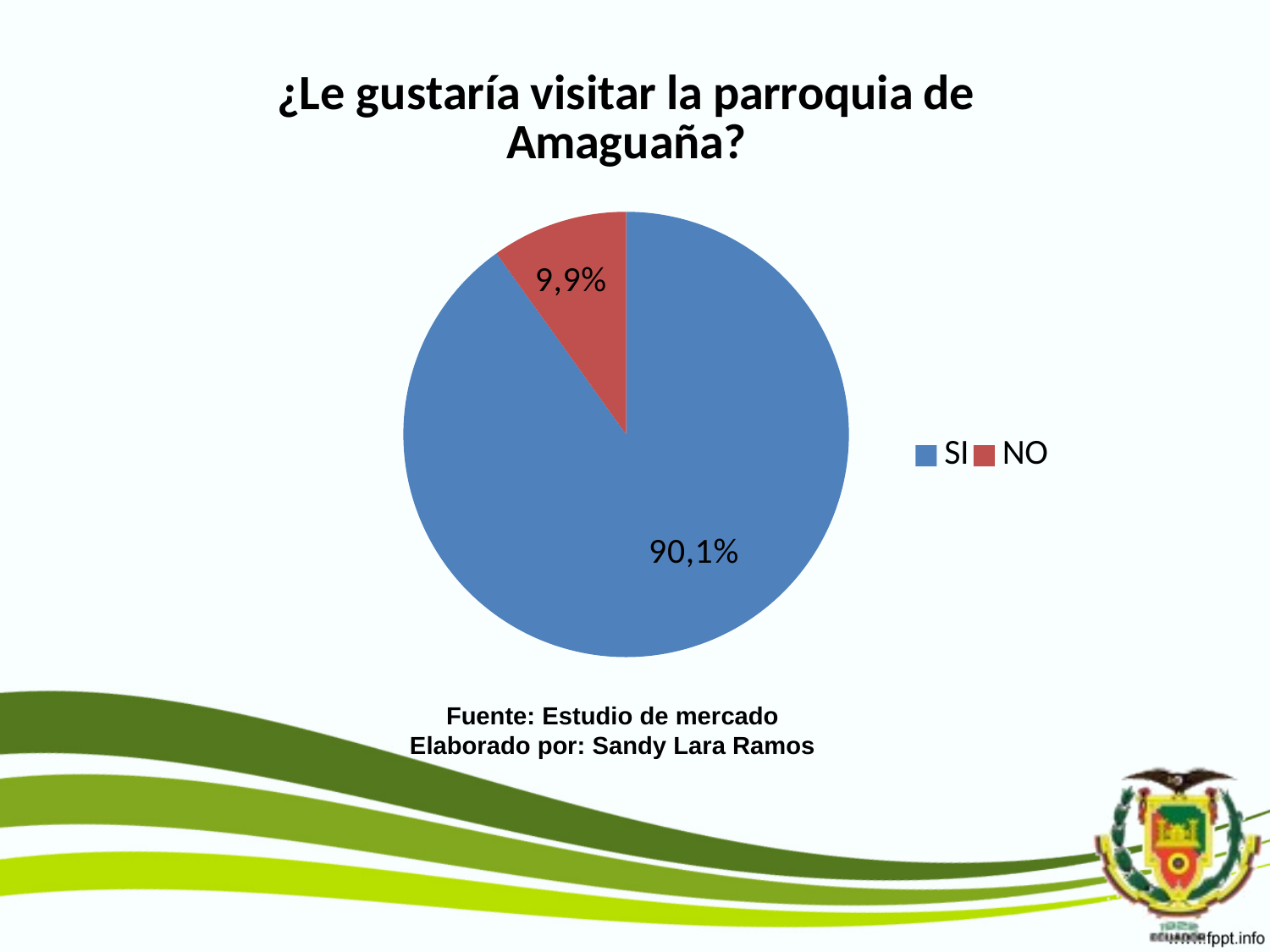
What is the title of the chart? ¿Le gustaría visitar la parroquia de Amaguaña? How many slices does the pie chart have? 2 What percentage of respondents answered NO? 9,9% Which response has the smallest share of the pie? NO What colour is the SI slice? Blue How many entries does the legend list? 2 Which response has the largest share of the pie? SI What is the difference in percentage points between the SI and NO slices? 80,2 What kind of chart is shown on the slide? Pie chart What percentage of respondents answered SI? 90,1% What share of the pie does the NO slice represent? 9,9% Which is larger, the SI slice or the NO slice? SI